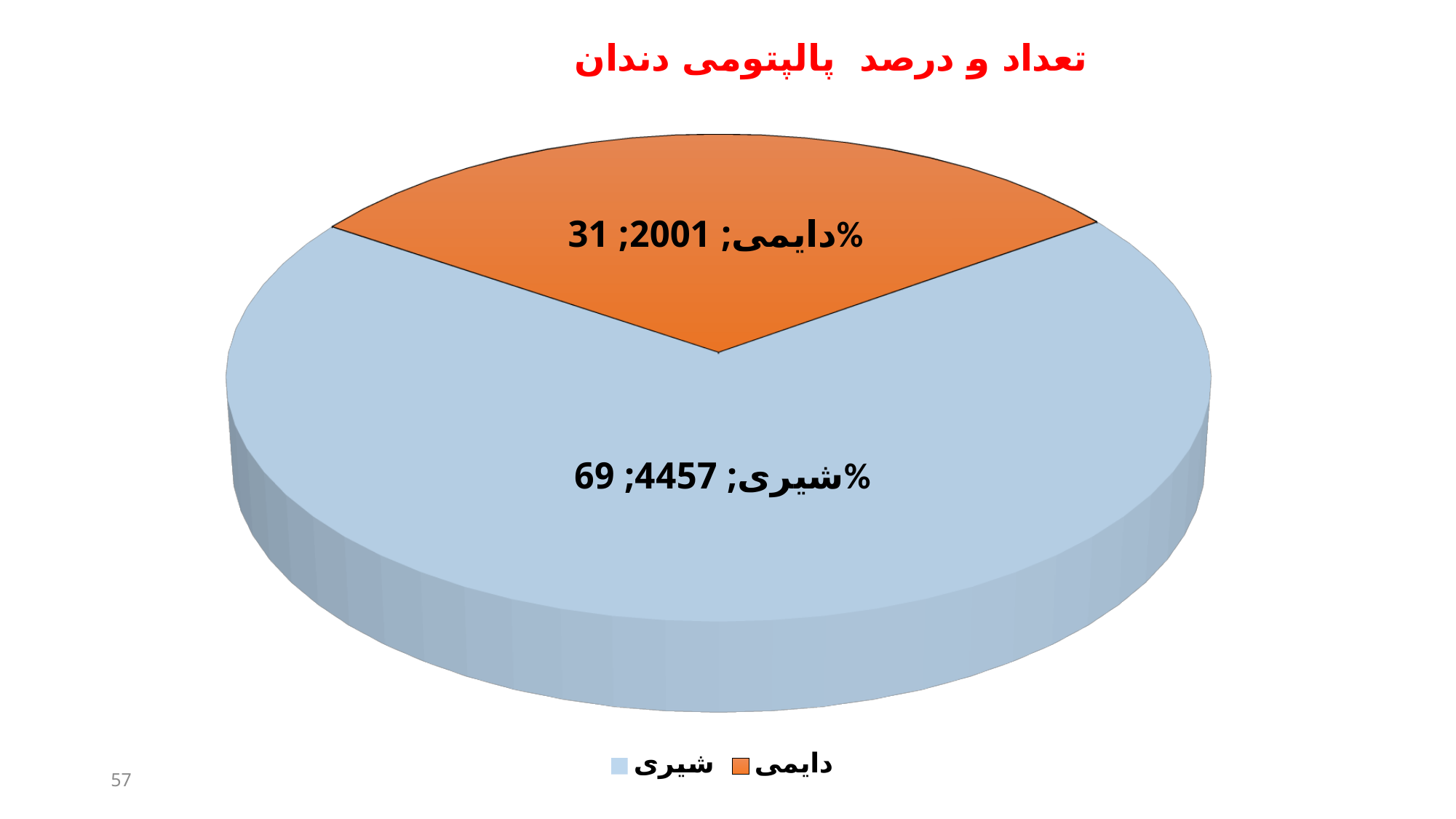
What is the count shown for the شیری slice? 4457 Which category has the smallest slice of the pie? دایمی What is the total of the two counts shown on the pie chart? 6458 What percentage is shown for the دایمی slice? 31% What is the difference between the counts for شیری and دایمی? 2456 What is the count shown for the دایمی slice? 2001 What type of chart is shown on the slide? Pie chart How many slices does the pie chart have? 2 What percentage is shown for the شیری slice? 69% What colour is the دایمی slice? Orange Which category has the largest slice of the pie? شیری Which is larger, the count for شیری or the count for دایمی? شیری